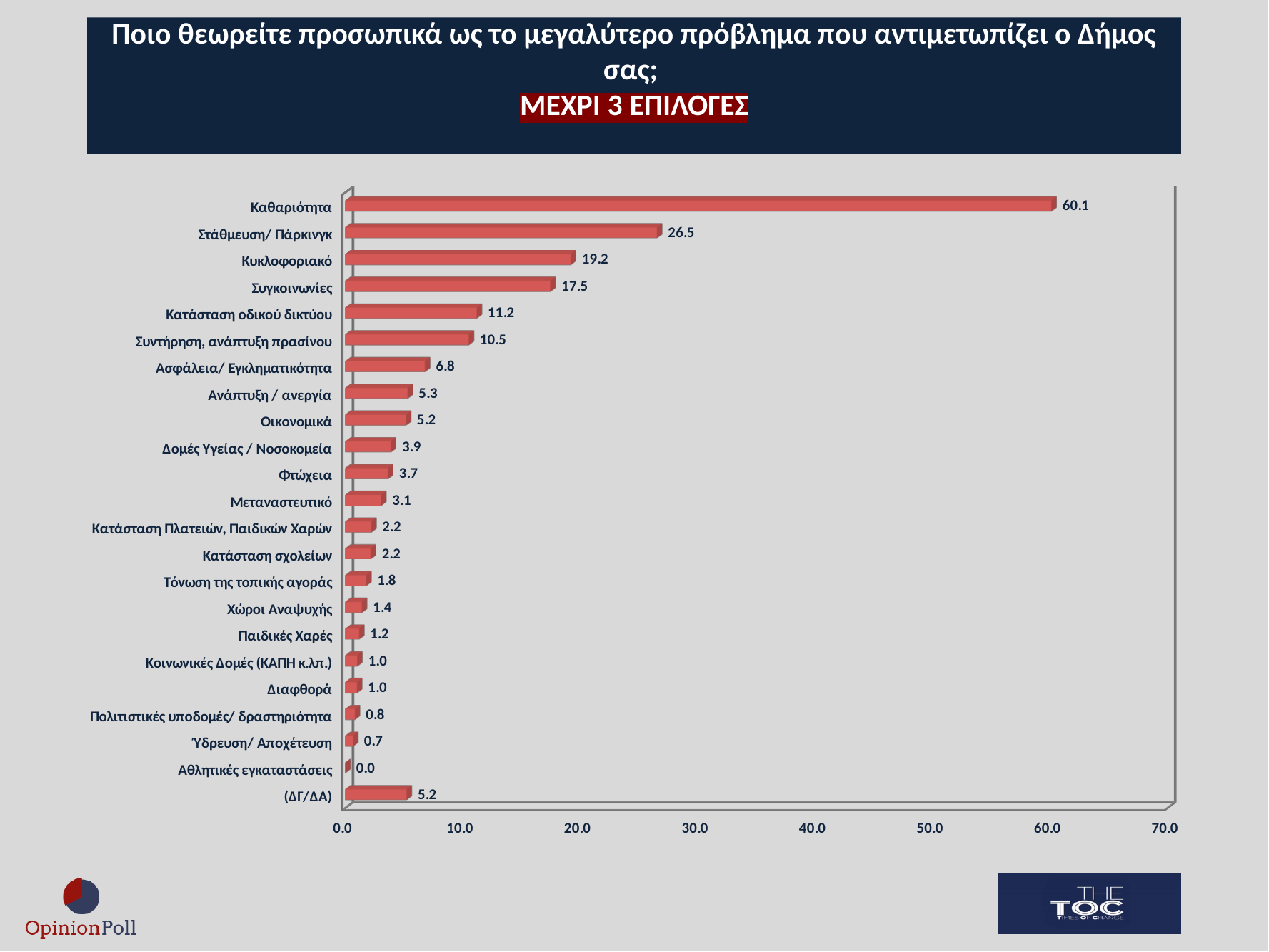
What is the value for Συντήρηση, ανάπτυξη πρασίνου? 10.5 What is the value for Στάθμευση/ Πάρκινγκ? 26.5 What is the difference between the values for Κυκλοφοριακό and Συγκοινωνίες? 1.7 Which category has the lowest value? Αθλητικές εγκαταστάσεις What kind of chart is shown on the slide? bar chart Which is larger, the value for Ασφάλεια/ Εγκληματικότητα or the value for Φτώχεια? Ασφάλεια/ Εγκληματικότητα What is the value for (ΔΓ/ΔΑ)? 5.2 How many categories are shown in the chart? 23 What is the value for Καθαριότητα? 60.1 What is the difference between the values for Καθαριότητα and Στάθμευση/ Πάρκινγκ? 33.6 Is the value for Κατάσταση οδικού δικτύου greater or less than 10.0? greater Which category has the highest value? Καθαριότητα